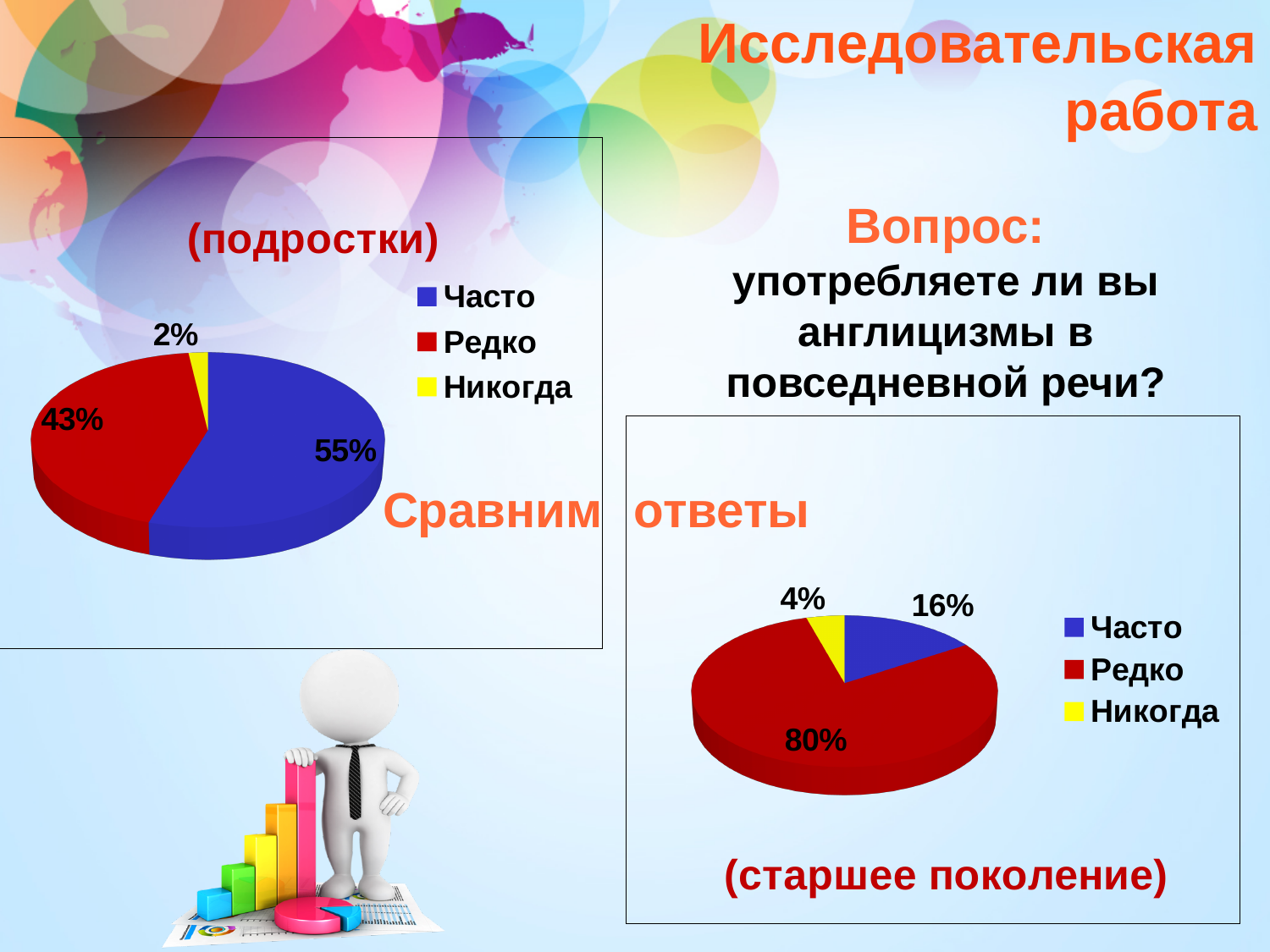
In the "(старшее поколение)" pie chart, what is the difference between the "Редко" and "Часто" percentages? 64% How many categories does the "(старшее поколение)" pie chart have? 3 In the "(подростки)" pie chart, which category has the largest slice? Часто In the "(подростки)" pie chart, what is the difference between the "Часто" and "Редко" percentages? 12% In the "(старшее поколение)" pie chart, what percentage is shown for "Редко"? 80% In the "(подростки)" chart legend, which colour represents "Редко"? Red In the "(подростки)" pie chart, what percentage is shown for "Никогда"? 2% In the "(подростки)" pie chart, what percentage is shown for "Часто"? 55% Which is larger: "Часто" in the "(подростки)" chart or "Часто" in the "(старшее поколение)" chart? "Часто" in the "(подростки)" chart What type of chart is the "(подростки)" chart? Pie chart In the "(старшее поколение)" pie chart, what percentage is shown for "Часто"? 16% In the "(старшее поколение)" pie chart, which category has the smallest slice? Никогда